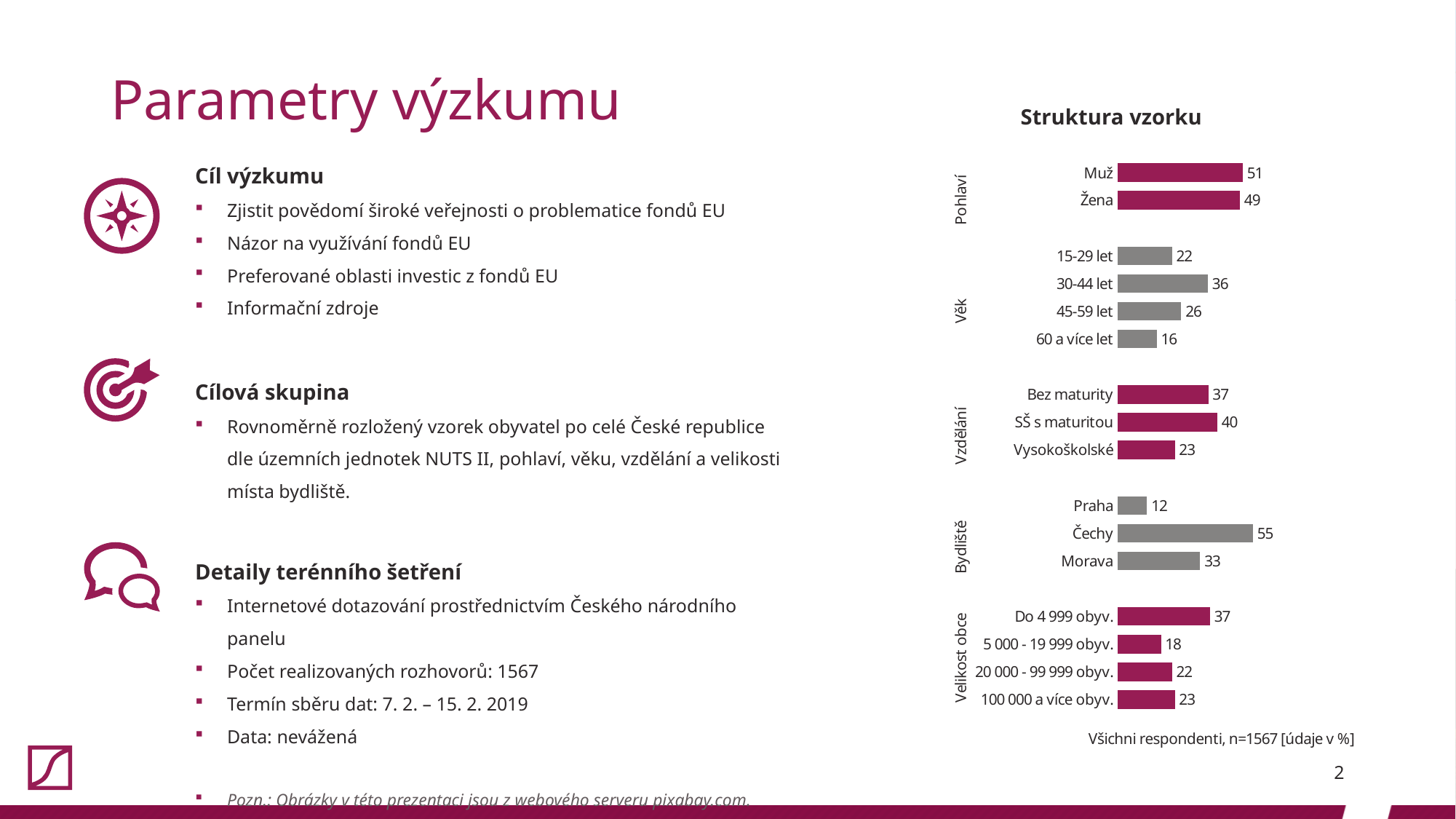
What is the value for 30-44 let in the Struktura vzorku chart? 36 What is the value for Vysokoškolské in the Struktura vzorku chart? 23 What is the value for Muž in the Struktura vzorku chart? 51 Which category in the Bydliště group has the highest value? Čechy What is the value for 100 000 a více obyv. in the Struktura vzorku chart? 23 What kind of chart is Struktura vzorku? bar chart What is the difference between the values for SŠ s maturitou and Bez maturity? 3 Which is larger, the value for Do 4 999 obyv. or the value for 5 000 - 19 999 obyv.? Do 4 999 obyv. How many categories are plotted in the Velikost obce group? 4 What is the title of the chart on the slide? Struktura vzorku Which category in the Věk group has the lowest value? 60 a více let What is the difference between the values for Čechy and Praha? 43